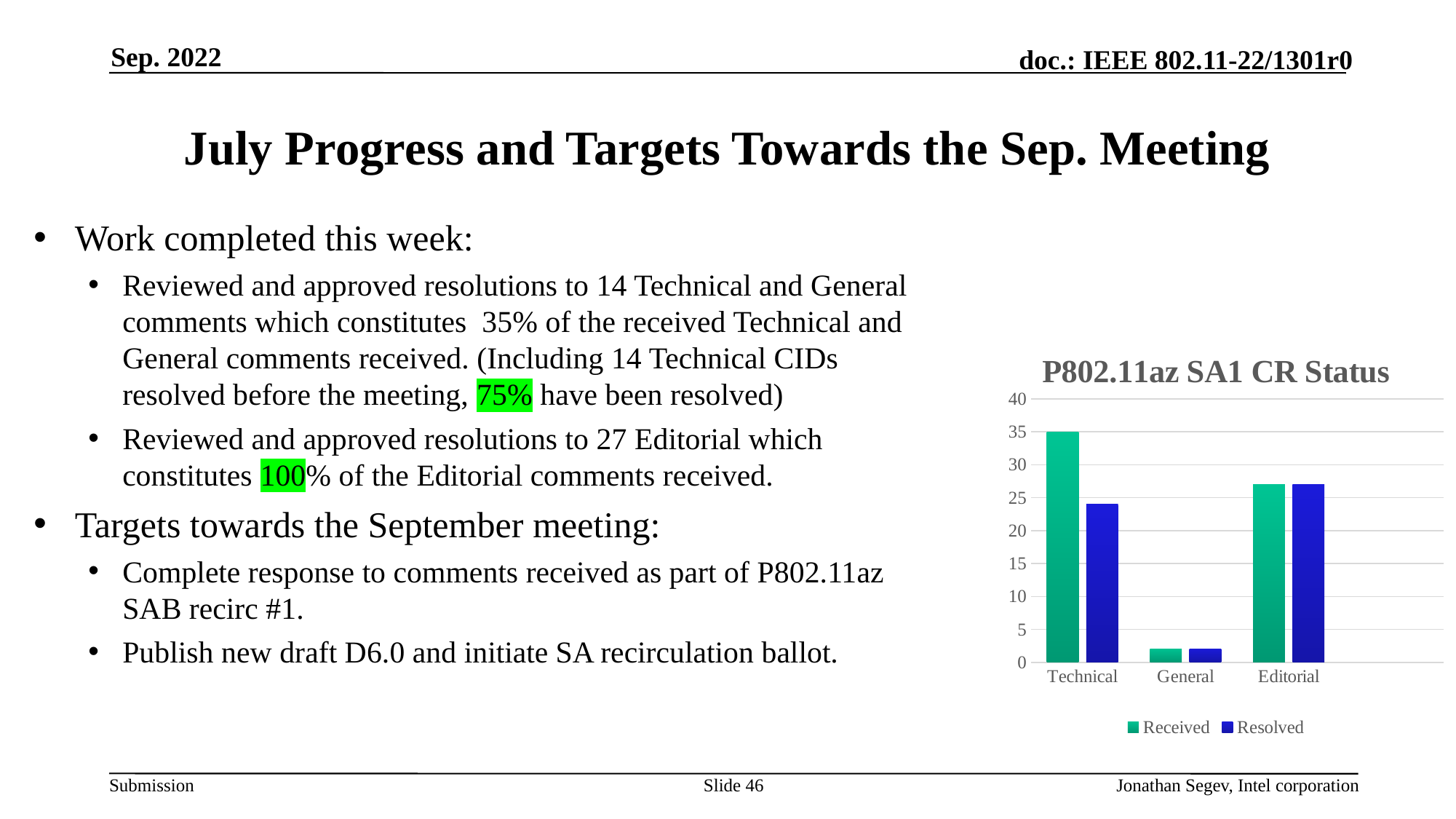
Which category has the lowest Resolved value? General Which category has the highest Received value? Technical Is the Resolved value for Technical greater or less than 30? less Is the Received value for General greater or less than 5? less How many categories are shown on the x axis of the chart? 3 Is the Resolved value for Editorial greater or less than 25? greater What is the title of the chart? P802.11az SA1 CR Status Which is larger for Technical, the Received value or the Resolved value? Received What kind of chart is shown on the slide? bar chart How many series does the chart legend list? 2 Which category has a larger Received value, Technical or Editorial? Technical